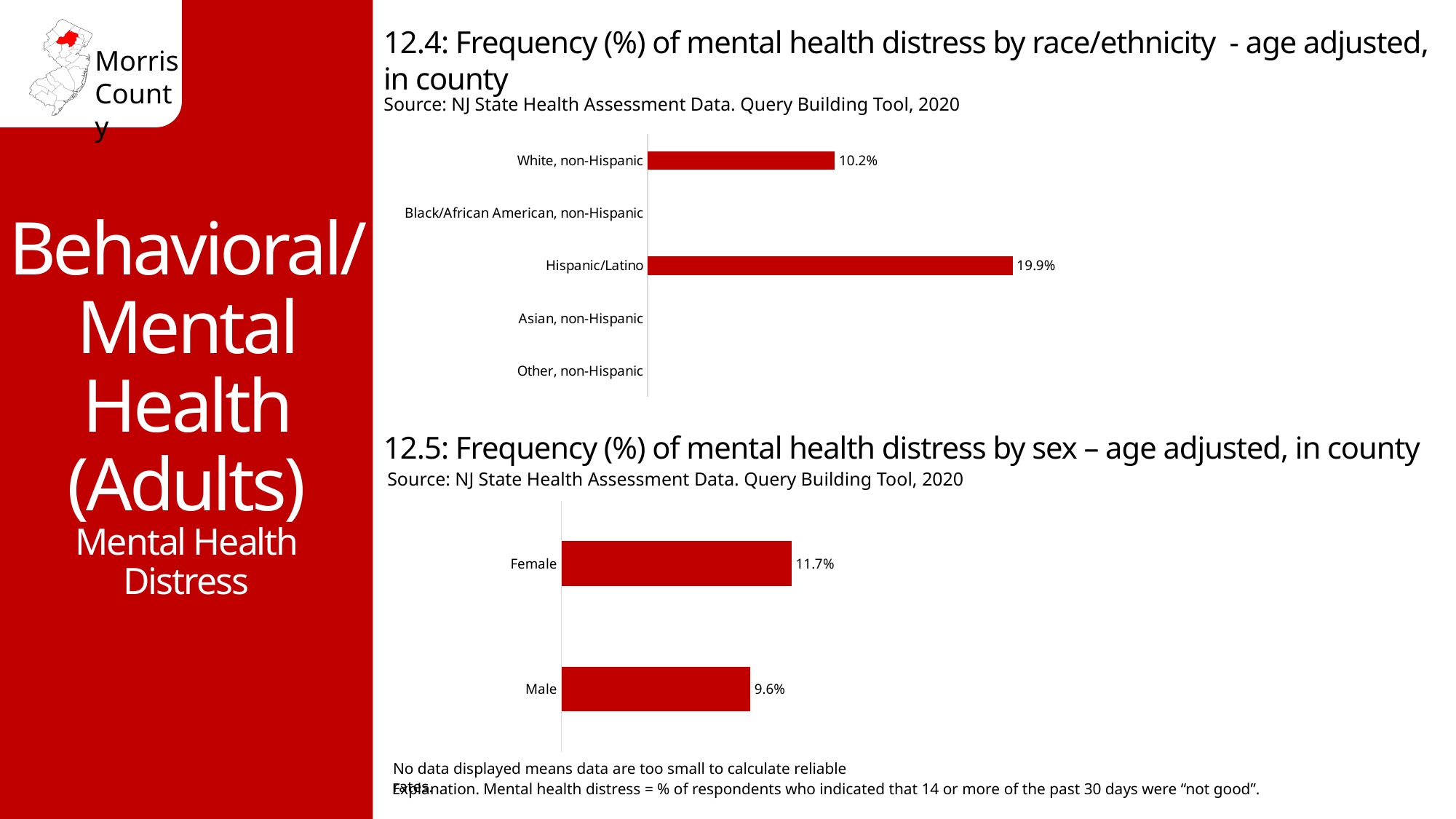
In chart 12.5 (mental health distress by sex), what is the value for Female? 11.7% What kind of chart is chart 12.5 (mental health distress by sex)? Bar chart In chart 12.4 (mental health distress by race/ethnicity), what is the value for Hispanic/Latino? 19.9% In chart 12.5 (mental health distress by sex), what is the difference between the Female and Male values? 2.1% In chart 12.4 (mental health distress by race/ethnicity), what is the value for White, non-Hispanic? 10.2% In chart 12.4 (mental health distress by race/ethnicity), which category has the highest value? Hispanic/Latino In chart 12.5 (mental health distress by sex), what is the value for Male? 9.6% In chart 12.4 (mental health distress by race/ethnicity), what is the difference between the Hispanic/Latino and White, non-Hispanic values? 9.7% In chart 12.5 (mental health distress by sex), which is larger, the Female value or the Male value? Female In chart 12.4 (mental health distress by race/ethnicity), how many race/ethnicity categories are listed on the axis? 5 In chart 12.4 (mental health distress by race/ethnicity), which categories have no bar displayed? Black/African American, non-Hispanic; Asian, non-Hispanic; Other, non-Hispanic In chart 12.5 (mental health distress by sex), how many categories are shown? 2